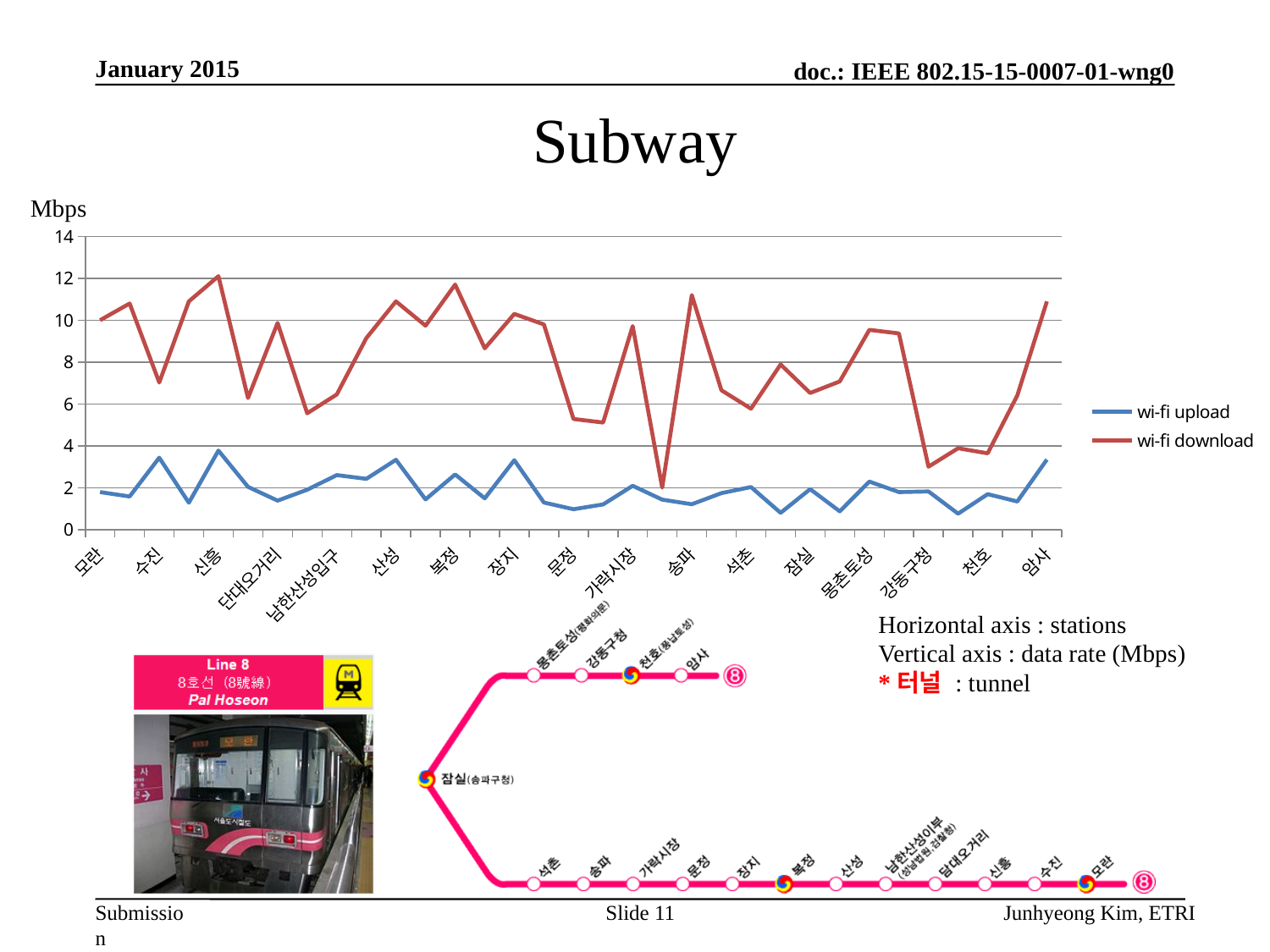
What unit is shown for the vertical axis of the chart? Mbps Is the wi-fi download value at 강동구청 greater or less than 4? less How many series does the chart's legend list? 2 What are the two series named in the chart's legend? wi-fi upload, wi-fi download Is the wi-fi upload value at 암사 greater or less than 2? greater Is the wi-fi download value at 문정 greater or less than 6? less At 신흥, which is larger: wi-fi upload or wi-fi download? wi-fi download What kind of chart is shown on the slide? line chart Which series is higher across the whole chart, wi-fi upload or wi-fi download? wi-fi download